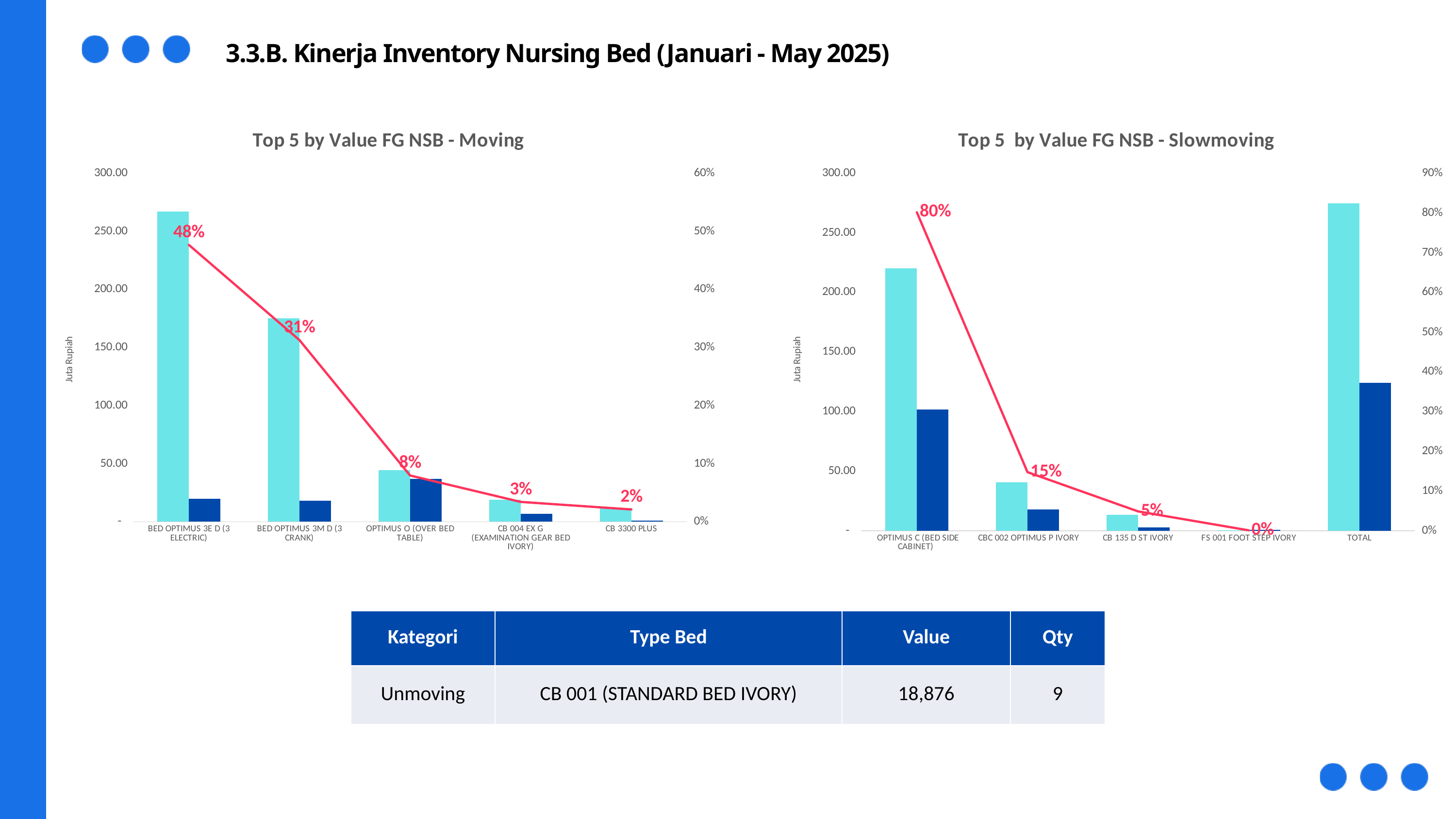
Does the red line in the 'Top 5 by Value FG NSB - Moving' chart rise or fall from left to right? fall In the 'Top 5 by Value FG NSB - Slowmoving' chart, which category has the highest percentage on the line? OPTIMUS C (BED SIDE CABINET) In the 'Top 5 by Value FG NSB - Moving' chart, which category has the lowest percentage on the line? CB 3300 PLUS In the 'Top 5 by Value FG NSB - Moving' chart, what percentage is shown on the line for OPTIMUS O (OVER BED TABLE)? 8% In the 'Top 5 by Value FG NSB - Moving' chart, is the light blue bar for BED OPTIMUS 3E D (3 ELECTRIC) greater or less than 250.00? greater In the 'Top 5 by Value FG NSB - Slowmoving' chart, what percentage is shown on the line for CBC 002 OPTIMUS P IVORY? 15% What is the y-axis label on the left side of the 'Top 5 by Value FG NSB - Moving' chart? Juta Rupiah In the 'Top 5 by Value FG NSB - Slowmoving' chart, what is the difference between the percentages for OPTIMUS C (BED SIDE CABINET) and CBC 002 OPTIMUS P IVORY? 65% In the 'Top 5 by Value FG NSB - Slowmoving' chart, is the light blue bar for OPTIMUS C (BED SIDE CABINET) greater or less than 200.00? greater How many categories are shown on the x axis of the 'Top 5 by Value FG NSB - Slowmoving' chart? 5 In the 'Top 5 by Value FG NSB - Moving' chart, what is the difference between the percentages for BED OPTIMUS 3E D (3 ELECTRIC) and BED OPTIMUS 3M D (3 CRANK)? 17% In the 'Top 5 by Value FG NSB - Moving' chart, what percentage is shown on the line for BED OPTIMUS 3E D (3 ELECTRIC)? 48%